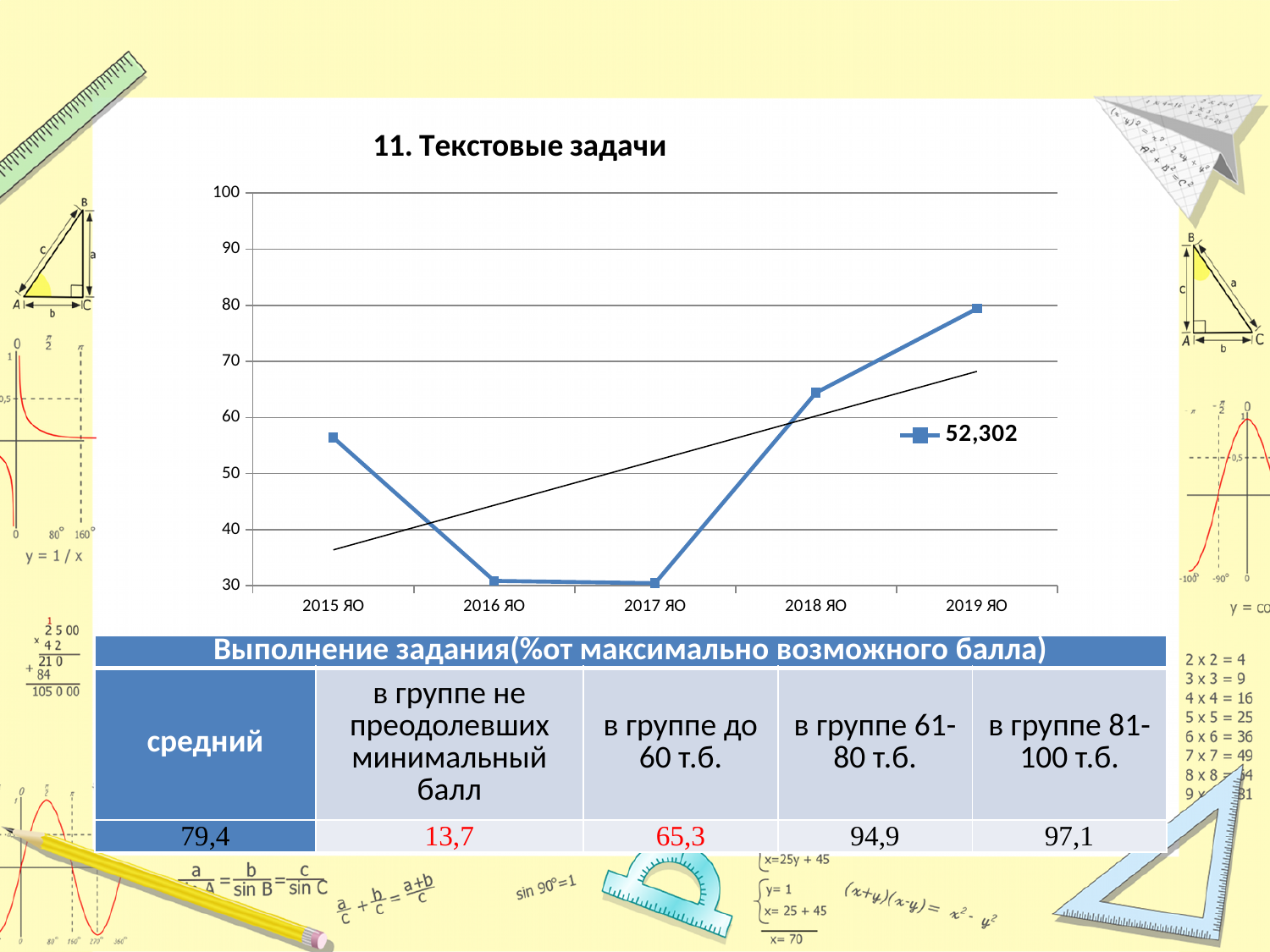
Is the value for 2016 ЯО greater or less than 40? less How many points are plotted along the x axis of the chart? 5 Is the value for 2019 ЯО greater or less than 70? greater Is the value for 2018 ЯО greater or less than 60? greater Which is larger, the value for 2015 ЯО or the value for 2018 ЯО? 2018 ЯО Do the values rise or fall from 2017 ЯО to 2019 ЯО? rise What entry is shown in the chart legend? 52,302 What kind of chart is shown on the slide? line chart What is the title of the chart? 11. Текстовые задачи Which year has the highest value on the chart? 2019 ЯО How many series does the chart legend list? 1